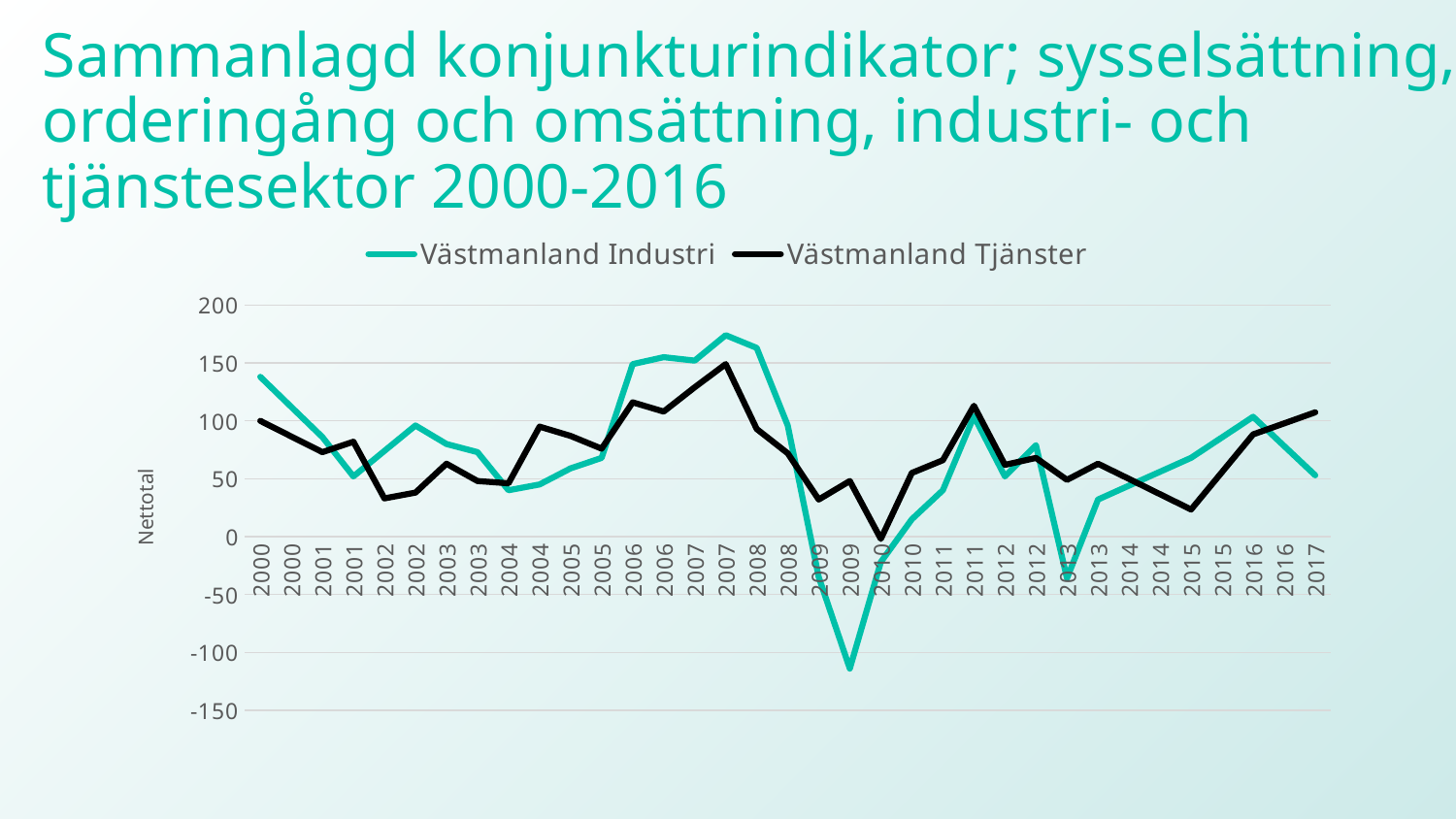
How many series does the legend list? 2 In which year does Västmanland Tjänster reach its highest value? 2007 What is the label on the vertical axis? Nettotal Is the lowest value for Västmanland Industri greater or less than -100? less What are the two series named in the legend? Västmanland Industri and Västmanland Tjänster Is the value for Västmanland Industri at the first 2013 point greater or less than 0? less In which year does Västmanland Industri reach its lowest value? 2009 Is the value for Västmanland Tjänster at the first 2015 point greater or less than 50? less Does the Västmanland Industri line rise or fall from the last 2016 point to the 2017 point? fall At the 2017 point, which series has the higher value, Västmanland Industri or Västmanland Tjänster? Västmanland Tjänster What type of chart is shown on the slide? line chart